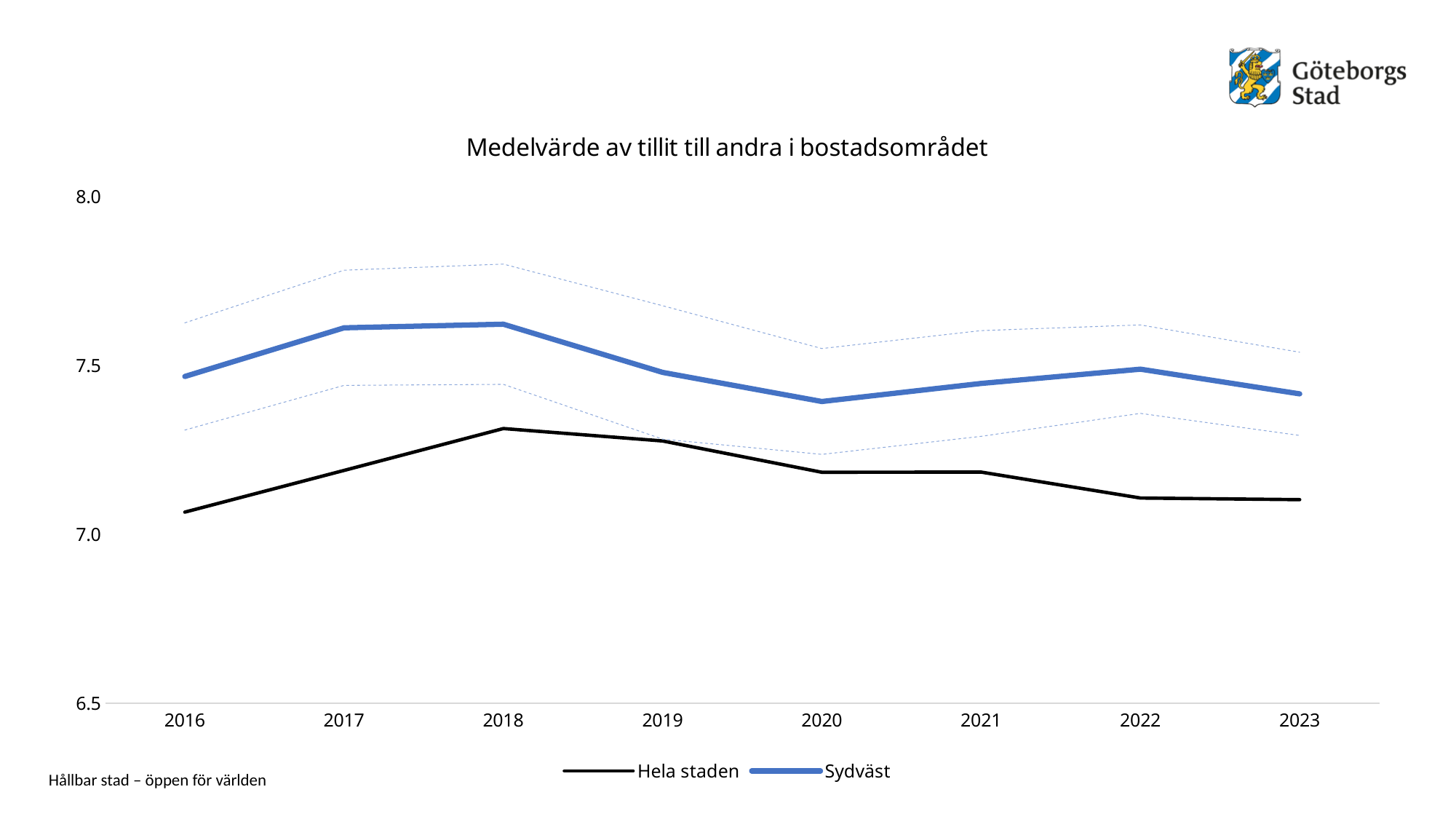
What is the title of the chart? Medelvärde av tillit till andra i bostadsområdet Is the value for Sydväst in 2017 greater or less than 7.5? greater Which series has the higher value in 2020, Hela staden or Sydväst? Sydväst In which year does the Hela staden line have its lowest value? 2016 Is the value for Hela staden in 2016 greater or less than 7.0? greater Which series is drawn in blue? Sydväst What kind of chart is shown on the slide? line chart How many years are shown on the x axis? 8 In which year does the Hela staden line reach its highest value? 2018 Is the value for Hela staden in 2018 greater or less than 7.5? less How many series does the legend list? 2 Does the Hela staden line rise or fall from 2018 to 2022? fall